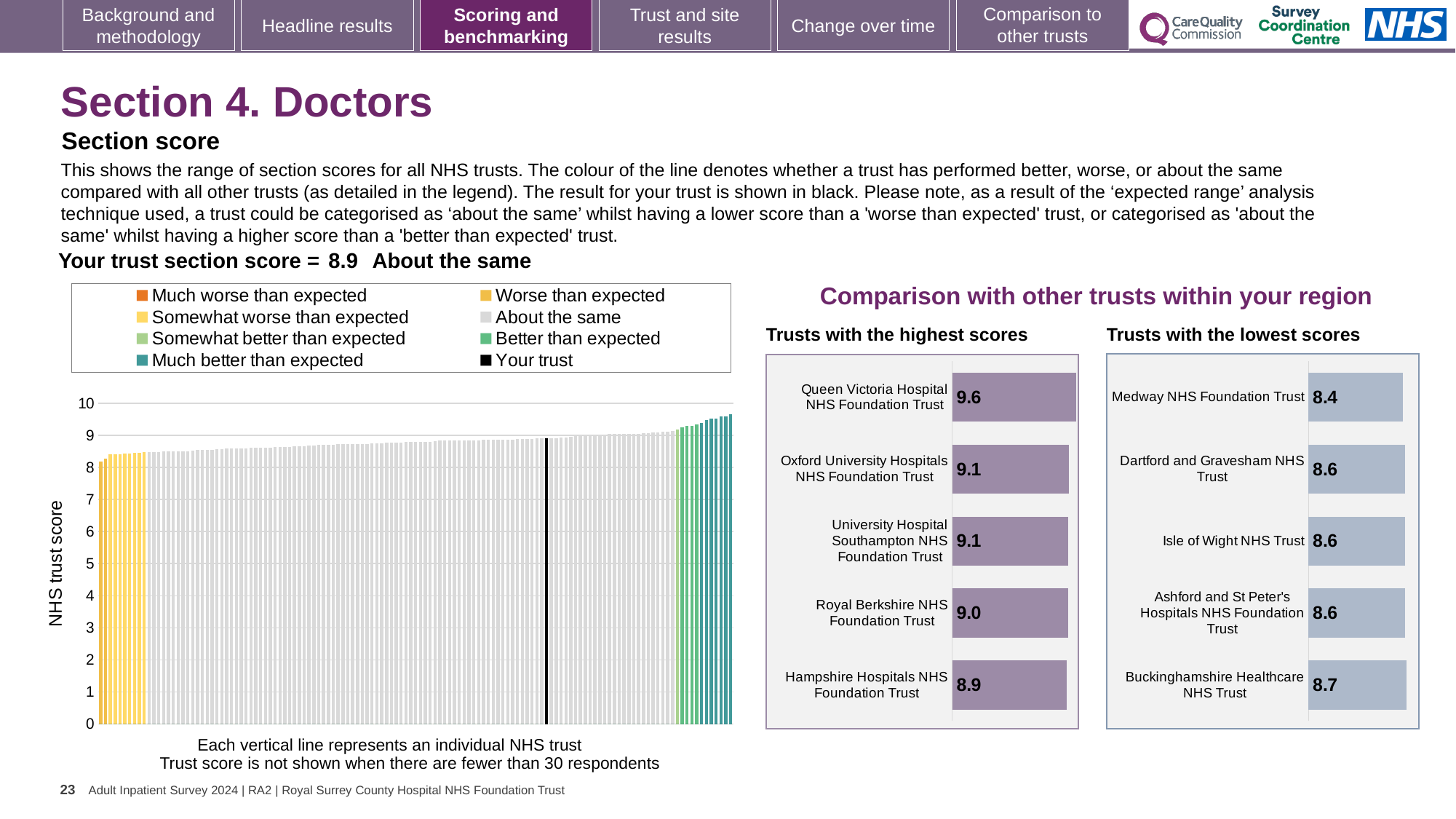
In the 'Trusts with the lowest scores' chart, which trust has the lowest score? Medway NHS Foundation Trust In the 'Trusts with the highest scores' chart, what is the score for Royal Berkshire NHS Foundation Trust? 9.0 In the 'Trusts with the highest scores' chart, which trust has the highest score? Queen Victoria Hospital NHS Foundation Trust In the 'Trusts with the lowest scores' chart, what is the difference between the scores of Buckinghamshire Healthcare NHS Trust and Medway NHS Foundation Trust? 0.3 Which has a higher score: Oxford University Hospitals NHS Foundation Trust in the highest scores chart, or Isle of Wight NHS Trust in the lowest scores chart? Oxford University Hospitals NHS Foundation Trust How many entries does the legend of the main NHS trust score chart list? 8 In the main NHS trust score chart, do the trust scores rise or fall from left to right along the x axis? rise In the 'Trusts with the highest scores' chart, what is the score for Queen Victoria Hospital NHS Foundation Trust? 9.6 How many trusts are listed in the 'Trusts with the lowest scores' chart? 5 In the 'Trusts with the lowest scores' chart, what is the score for Medway NHS Foundation Trust? 8.4 In the 'Trusts with the lowest scores' chart, what is the score for Buckinghamshire Healthcare NHS Trust? 8.7 In the 'Trusts with the highest scores' chart, what is the difference between the scores of Queen Victoria Hospital NHS Foundation Trust and Hampshire Hospitals NHS Foundation Trust? 0.7